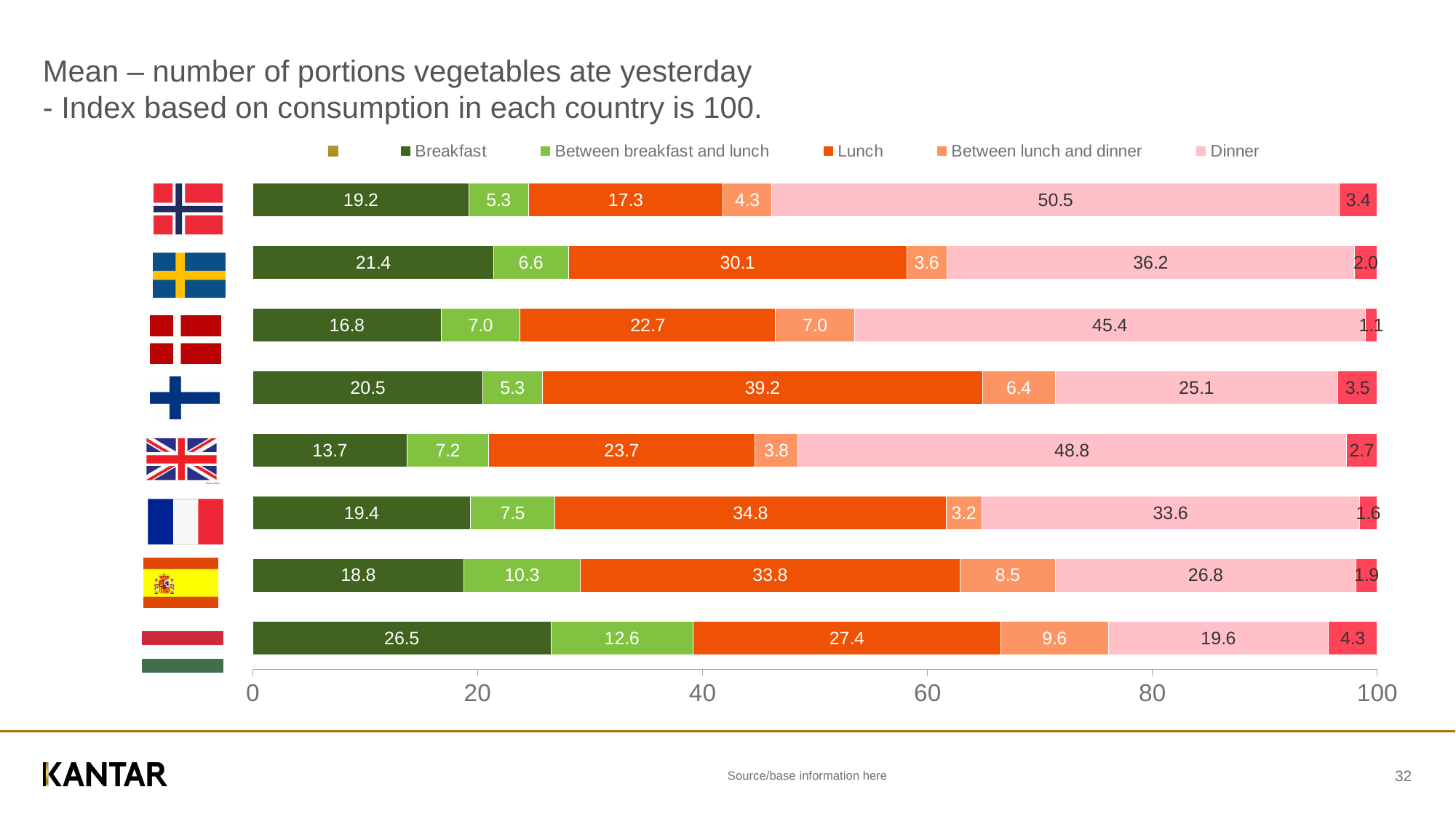
Which has the larger Lunch value, the second bar from the top or the third bar from the top? The second bar from the top Which bar has the highest Breakfast value? The bottom bar (26.5) Which bar has the lowest Breakfast value? The fifth bar from the top (13.7) What is the Dinner value for the top bar in the chart? 50.5 Which bar has the highest Lunch value? The fourth bar from the top (39.2) In the top bar, what is the difference between the Dinner value and the Breakfast value? 31.3 How many country bars are plotted in the chart? 8 What is the Lunch value for the bottom bar in the chart? 27.4 What is the Between breakfast and lunch value for the seventh bar from the top? 10.3 What is the title of the chart? Mean – number of portions vegetables ate yesterday - Index based on consumption in each country is 100. Is the Dinner value for the bottom bar greater or less than 20? less What kind of chart is shown on the slide? Stacked bar chart